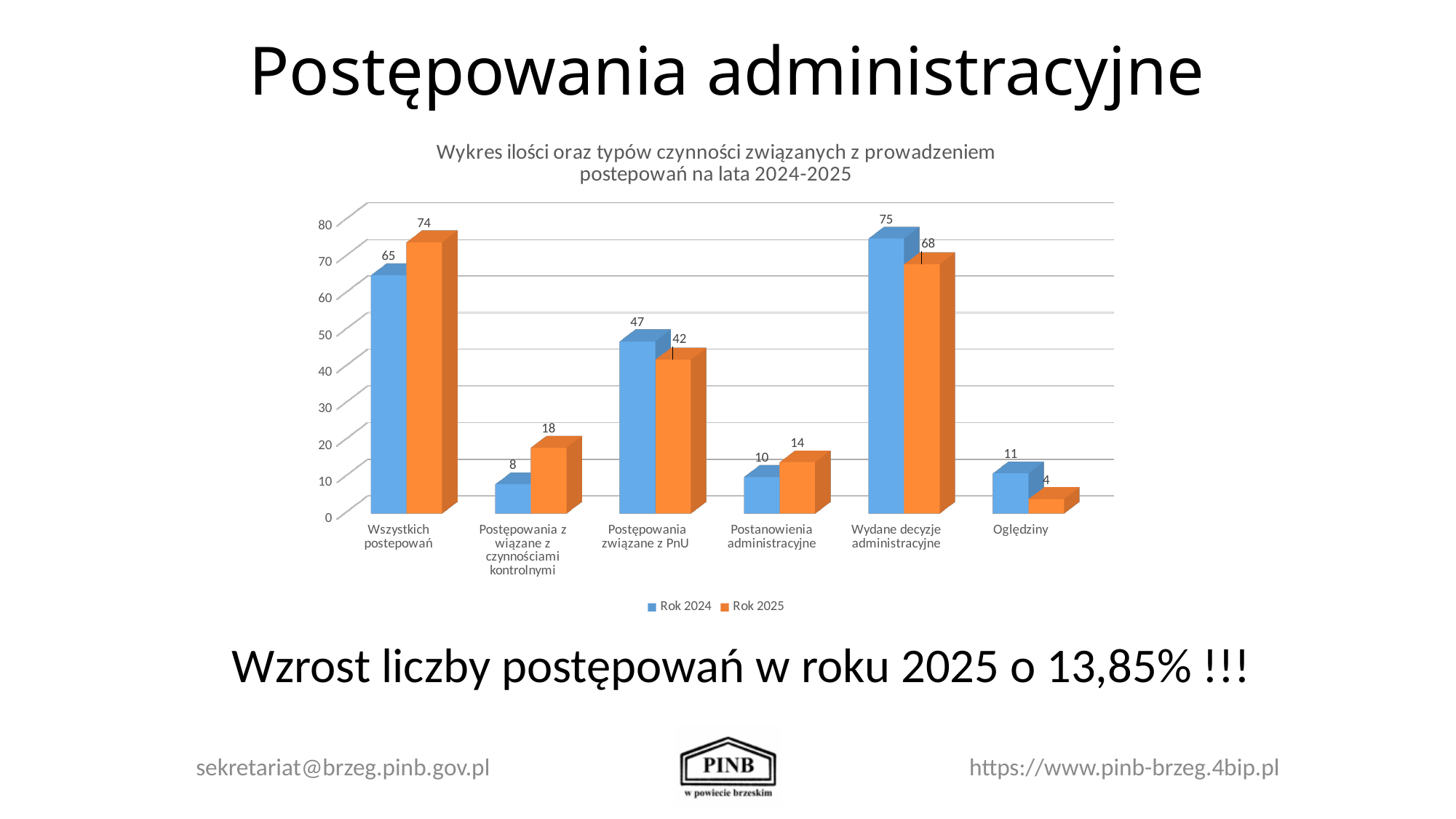
Which category has the lowest value for Rok 2025? Oględziny Is the Rok 2025 value for Wszystkich postępowań greater or less than 70? greater What is the difference between the Rok 2025 and Rok 2024 values for Postępowania związane z czynnościami kontrolnymi? 10 How many categories are shown on the x axis of the chart? 6 How many series does the chart legend list? 2 Which colour represents the Rok 2025 series in the chart? Orange What is the value for Rok 2025 in the Oględziny category? 4 Which is larger for Postępowania związane z PnU: the Rok 2024 value or the Rok 2025 value? Rok 2024 What type of chart is shown on the slide? Bar chart What is the value for Rok 2025 in the Wydane decyzje administracyjne category? 68 What is the value for Rok 2024 in the Wszystkich postępowań category? 65 Which category has the highest value for Rok 2024? Wydane decyzje administracyjne